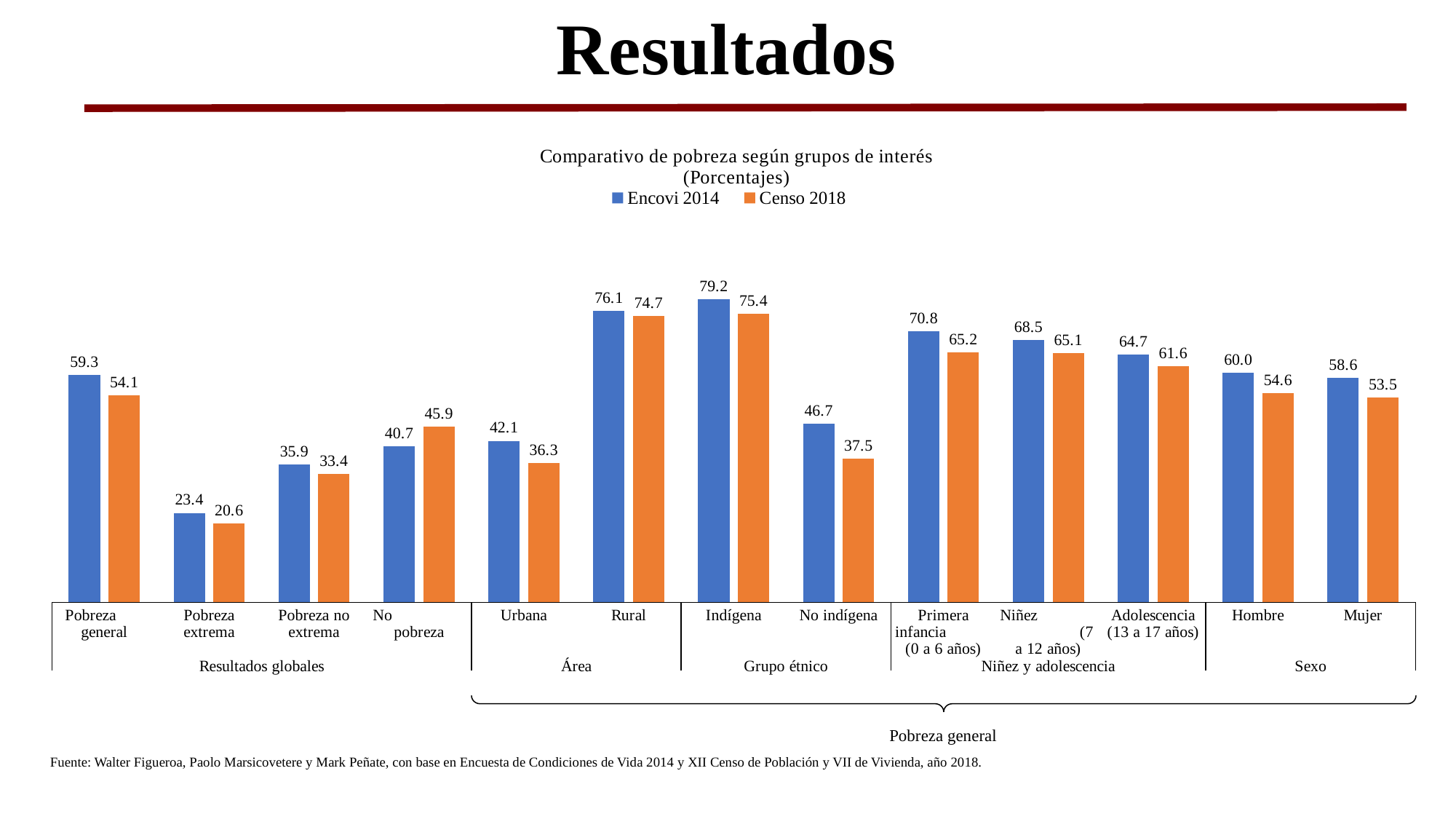
How many series does the legend list? 2 How many categories are shown on the x axis? 13 Which colour represents Censo 2018 in the chart? Orange What is the Censo 2018 value for Rural? 74.7 Which category has the highest Encovi 2014 value? Indígena What is the difference between the Encovi 2014 and Censo 2018 values for Primera infancia (0 a 6 años)? 5.6 What is the title of the chart? Comparativo de pobreza según grupos de interés (Porcentajes) What kind of chart is this? Bar chart What is the Censo 2018 value for No indígena? 37.5 Which is larger for No pobreza: the Encovi 2014 value or the Censo 2018 value? Censo 2018 Which category has the lowest Censo 2018 value? Pobreza extrema What is the Encovi 2014 value for Pobreza general? 59.3